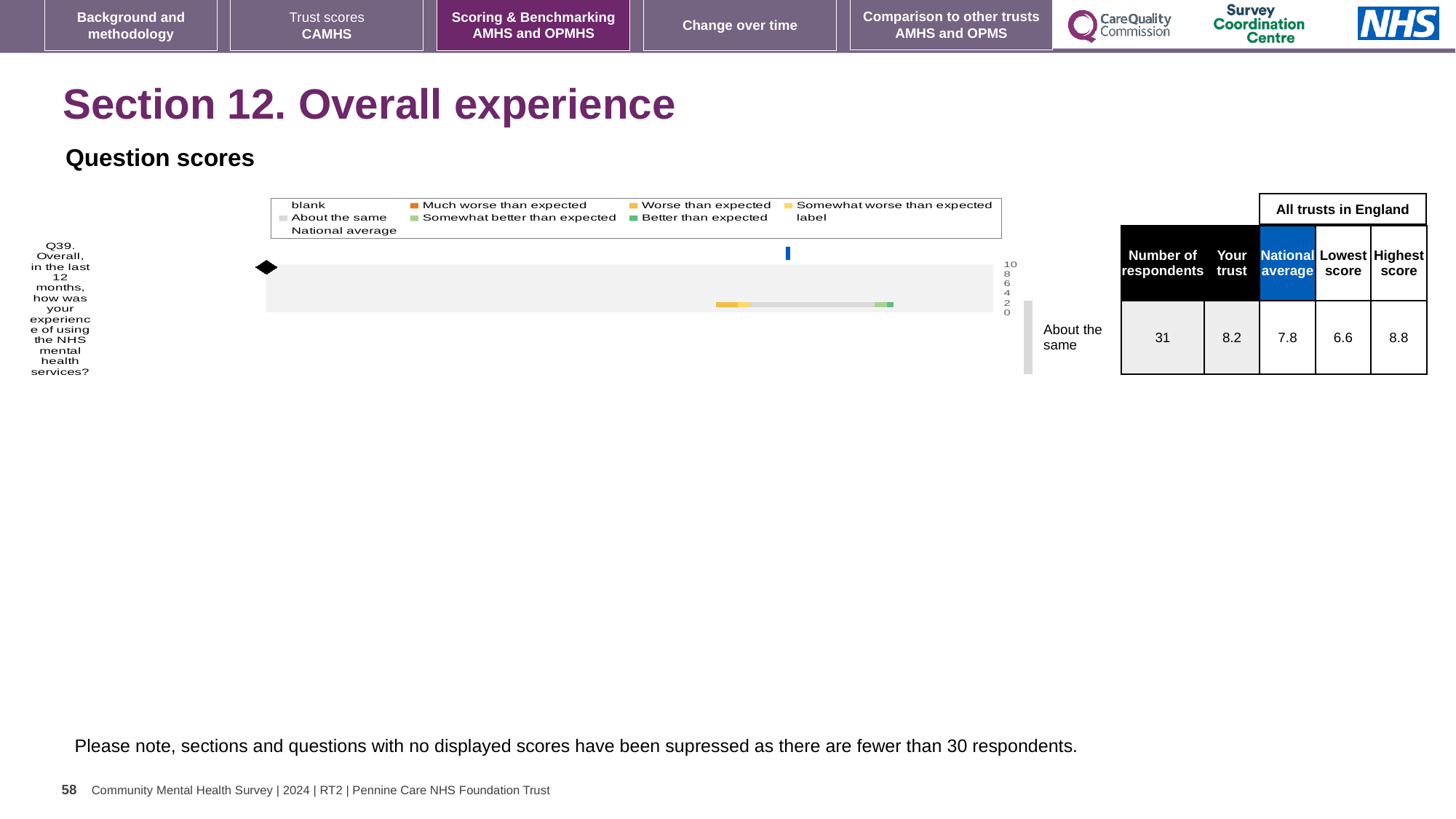
By how much does the 'Your trust' score for Q39 exceed the national average? 0.4 What is the lowest score among all trusts in England for Q39? 6.6 For Q39, which is higher: the 'Your trust' score or the national average? Your trust Which benchmark category is Q39 placed in? About the same What is the highest score among all trusts in England for Q39? 8.8 What kind of chart is used to show the Q39 score? bar chart What is the maximum value shown on the score axis of the chart? 10 What is the difference between the highest and lowest scores for Q39 across all trusts in England? 2.2 How many respondents answered Q39? 31 What is the 'Your trust' score for Q39 (Overall, in the last 12 months, how was your experience of using the NHS mental health services?)? 8.2 How many questions are plotted in the Question scores chart? 1 What is the national average score for Q39? 7.8